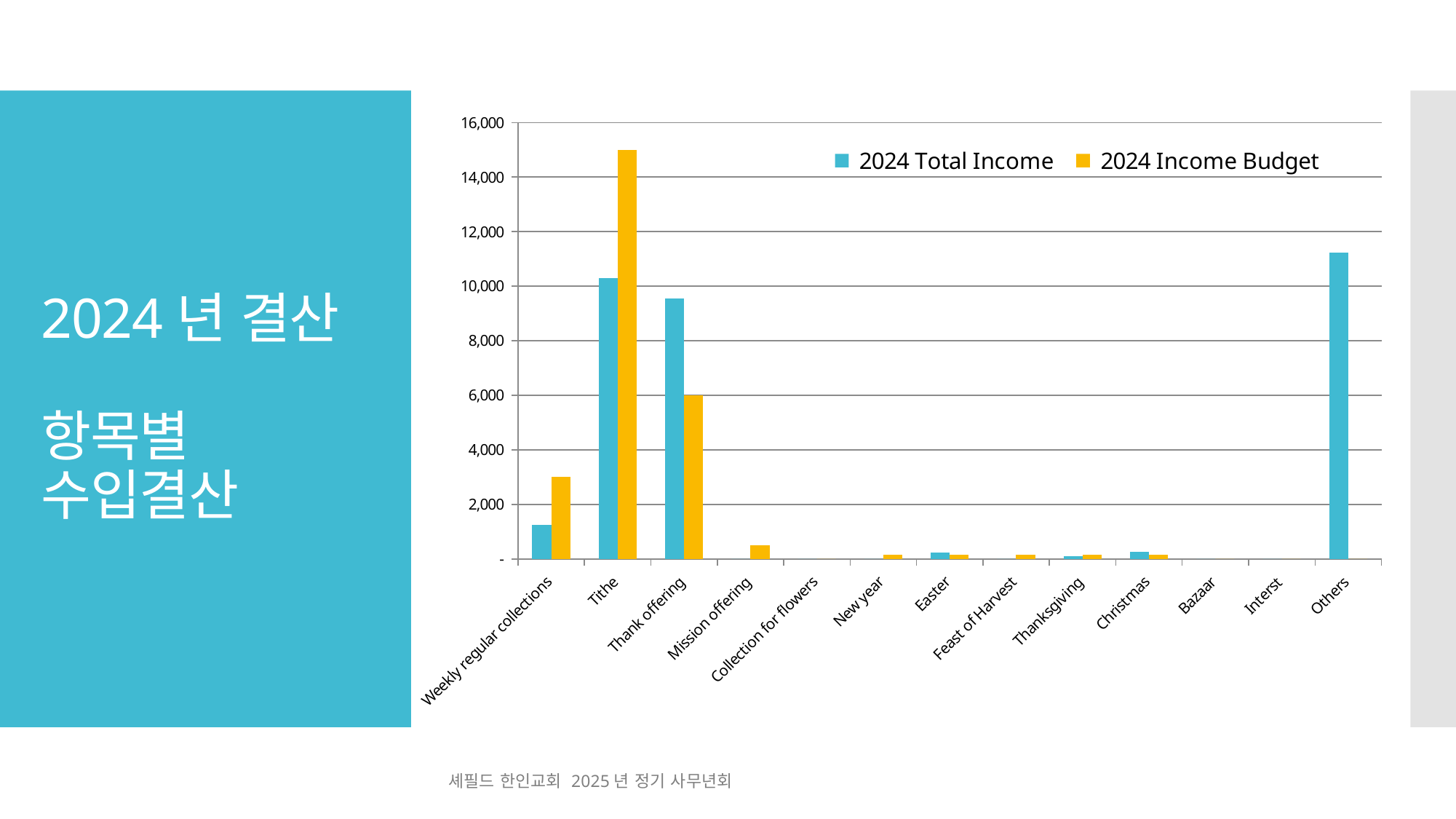
Is the 2024 Total Income value for Weekly regular collections greater or less than 2,000? less For Weekly regular collections, which is larger: 2024 Total Income or 2024 Income Budget? 2024 Income Budget How many series does the chart legend list? 2 Is the 2024 Income Budget value for Tithe greater or less than 14,000? greater Which category has the highest 2024 Total Income value? Others What kind of chart is shown on the slide? bar chart Which category has the highest 2024 Income Budget value? Tithe How many categories are shown on the x axis of the chart? 13 For Thank offering, which is larger: 2024 Total Income or 2024 Income Budget? 2024 Total Income What are the two series names listed in the chart legend? 2024 Total Income and 2024 Income Budget For Tithe, which is larger: 2024 Total Income or 2024 Income Budget? 2024 Income Budget Is the 2024 Total Income value for Others greater or less than 10,000? greater